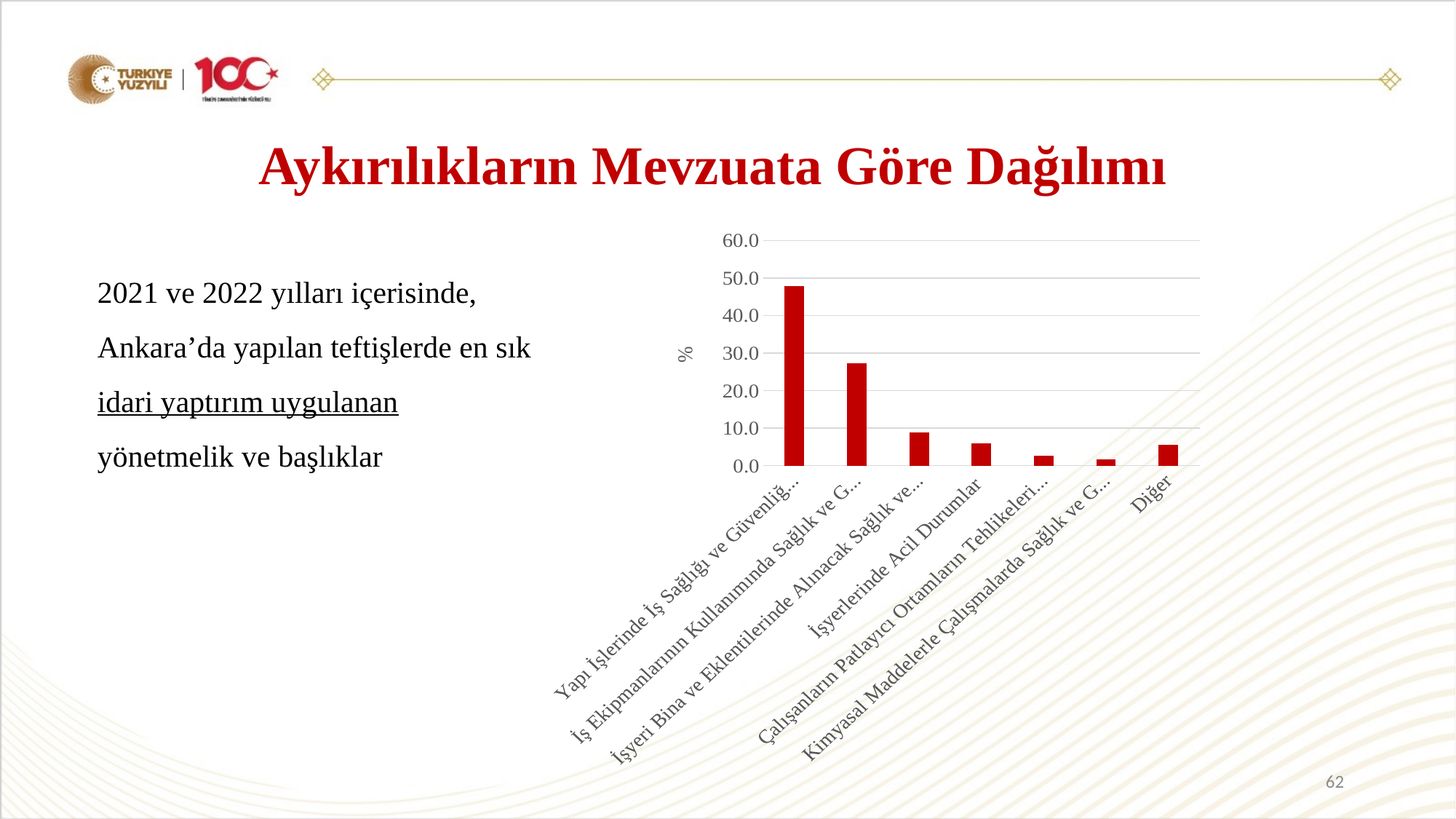
Is the value for the second bar (İş Ekipmanlarının Kullanımında Sağlık ve G...) greater or less than 30.0? less Which category has the lowest value in the chart? Kimyasal Maddelerle Çalışmalarda Sağlık ve G... What kind of chart is shown on the slide? Bar chart Is the value for İşyerlerinde Acil Durumlar greater or less than 10.0? less How many categories (bars) does the chart show? 7 Which category has the highest value in the chart? The first bar, Yapı İşlerinde İş Sağlığı ve Güvenliğ... What is the label on the vertical axis of the chart? % Is the value for the first bar (Yapı İşlerinde İş Sağlığı ve Güvenliğ...) greater or less than 40.0? greater Which is larger: the value for İşyeri Bina ve Eklentilerinde Alınacak Sağlık ve... or the value for İşyerlerinde Acil Durumlar? İşyeri Bina ve Eklentilerinde Alınacak Sağlık ve... Which is larger: the value for Diğer or the value for Çalışanların Patlayıcı Ortamların Tehlikeleri...? Diğer What is the title of the slide containing the chart? Aykırılıkların Mevzuata Göre Dağılımı